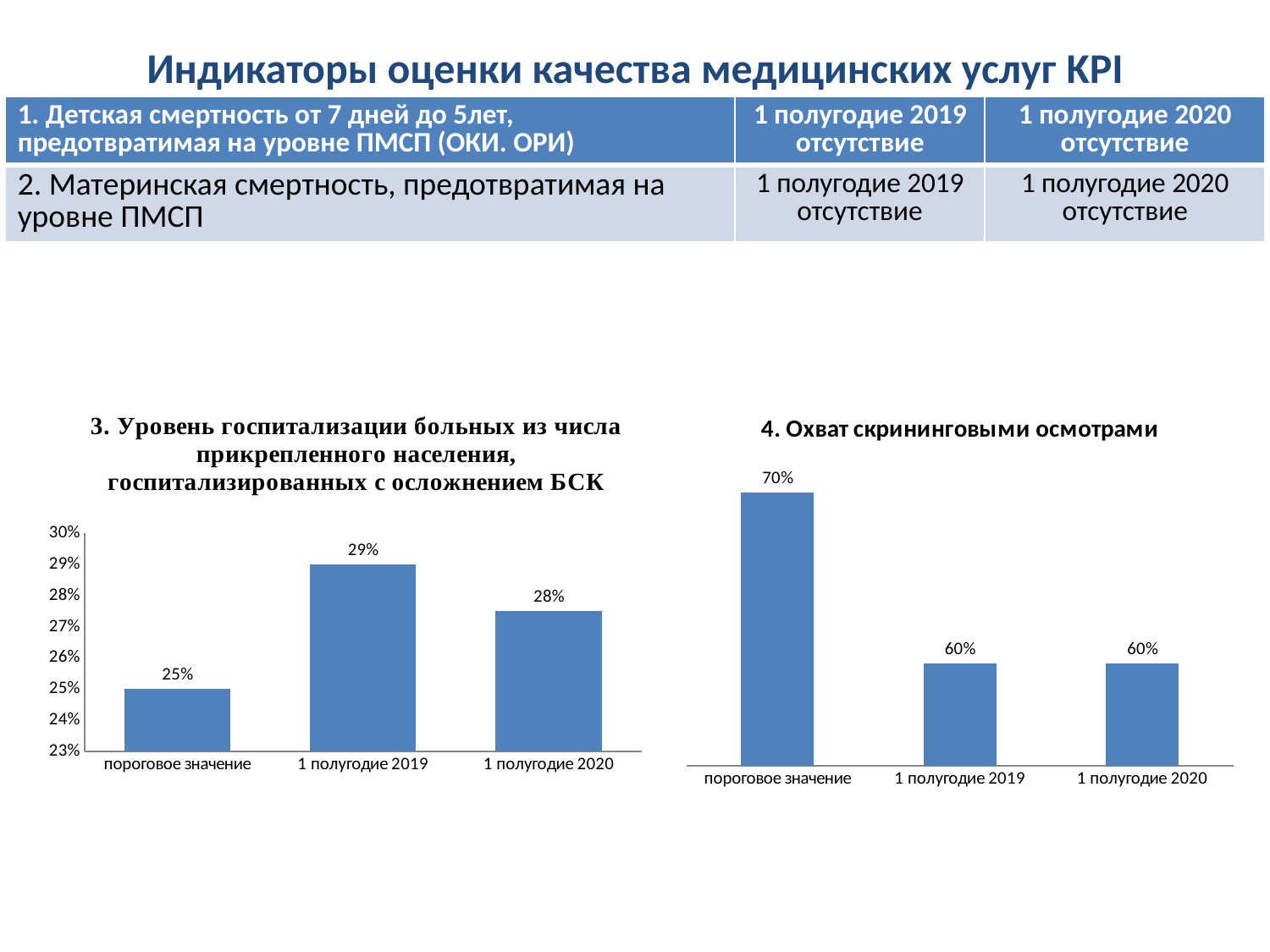
In the chart '4. Охват скрининговыми осмотрами', which category has the highest value? пороговое значение In the chart '4. Охват скрининговыми осмотрами', is the value for 1 полугодие 2019 larger or smaller than the value for пороговое значение? smaller In the chart '3. Уровень госпитализации больных...', how many categories are shown on the x axis? 3 In the chart '3. Уровень госпитализации больных...', what is the difference between the values for 1 полугодие 2019 and 1 полугодие 2020? 1% In the chart '3. Уровень госпитализации больных...', which category has the highest value? 1 полугодие 2019 What kind of chart is '4. Охват скрининговыми осмотрами'? bar chart In the chart '3. Уровень госпитализации больных из числа прикрепленного населения, госпитализированных с осложнением БСК', what is the value for 1 полугодие 2019? 29% In the chart '4. Охват скрининговыми осмотрами', what is the value for 1 полугодие 2020? 60% In the chart '3. Уровень госпитализации больных...', what is the value for пороговое значение? 25% In the chart '4. Охват скрининговыми осмотрами', what is the value for пороговое значение? 70% In the chart '4. Охват скрининговыми осмотрами', what is the difference between the values for пороговое значение and 1 полугодие 2019? 10% In the chart '3. Уровень госпитализации больных...', which category has the lowest value? пороговое значение